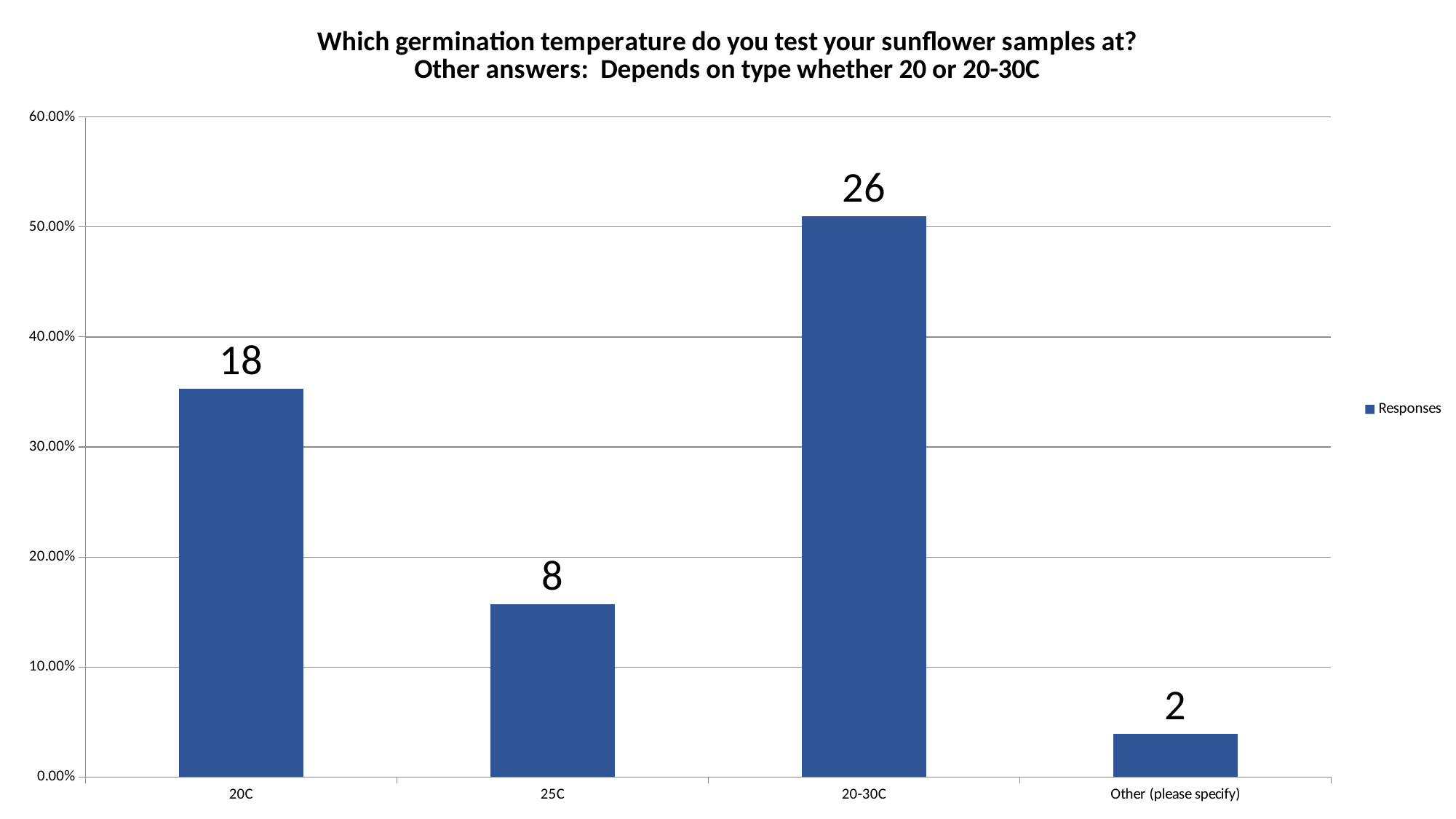
Which category has the lowest bar? Other (please specify) What is the data label shown above the bar for 20C? 18 What is the data label shown above the bar for 25C? 8 What is the difference between the data labels for 20-30C and 20C? 8 What is the data label shown above the bar for 20-30C? 26 Is the bar for 20-30C greater or less than 50.00% on the axis? greater Is the bar for 25C greater or less than 20.00% on the axis? less Which category has the highest bar? 20-30C What is the data label shown above the bar for Other (please specify)? 2 How many categories are shown on the x axis? 4 Which has a larger value, 20C or 25C? 20C What kind of chart is shown on the slide? Bar chart